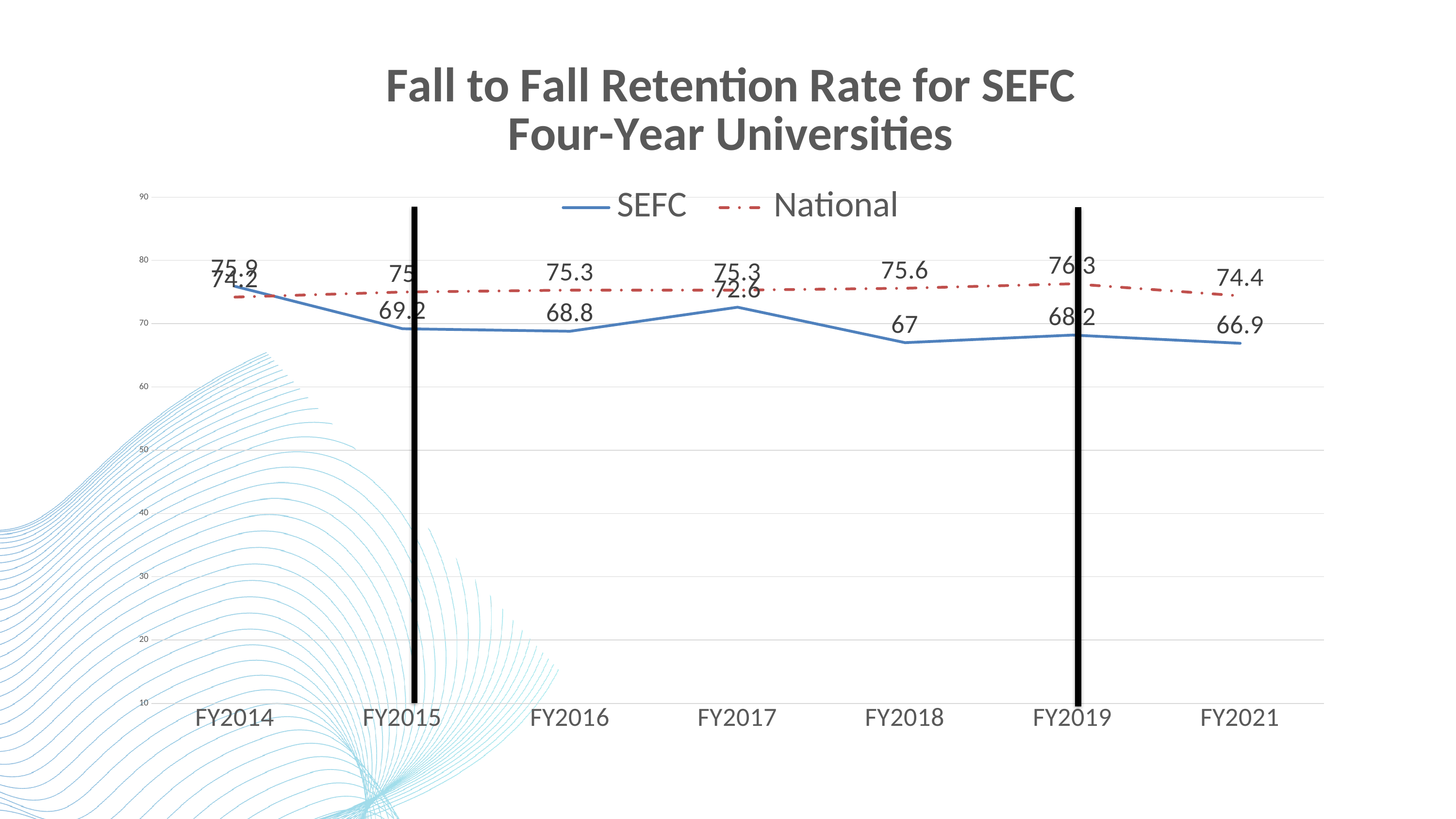
Is the SEFC value for FY2018 greater or less than 70? less What is the SEFC retention rate for FY2021? 66.9 In which fiscal year is the SEFC retention rate highest? FY2014 What is the difference between the National and SEFC retention rates in FY2021? 7.5 Does the SEFC retention rate rise or fall from FY2014 to FY2015? fall How many series does the legend list? 2 What is the SEFC retention rate for FY2016? 68.8 What is the National retention rate for FY2015? 75 In FY2017, which series has the higher retention rate, SEFC or National? National What is the National retention rate for FY2018? 75.6 How many fiscal years are plotted along the x axis? 7 What kind of chart is shown on the slide? line chart